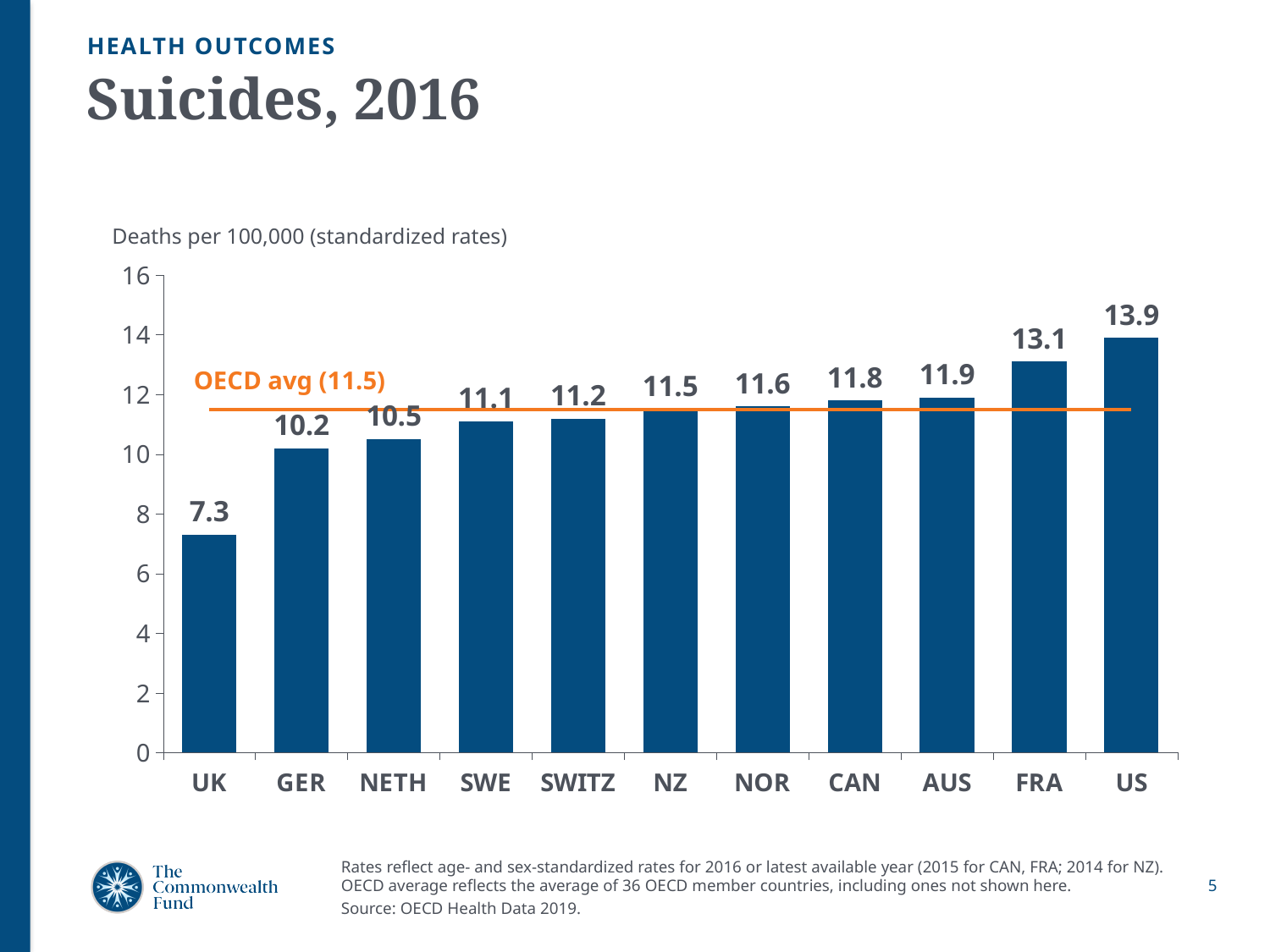
How many countries are shown on the chart? 11 Which country has the lowest suicide rate on the chart? UK What is the difference between the values for the US and the UK? 6.6 What is the suicide rate (deaths per 100,000) shown for the UK? 7.3 Do the values rise or fall moving from left to right along the x axis? Rise What kind of chart is shown on the slide? Bar chart What is the difference between the values for FRA and GER? 2.9 What OECD average value is marked by the orange line on the chart? 11.5 What value is shown for NETH? 10.5 What value is shown for FRA? 13.1 Which has a higher value, CAN or SWE? CAN Which country has the highest suicide rate on the chart? US